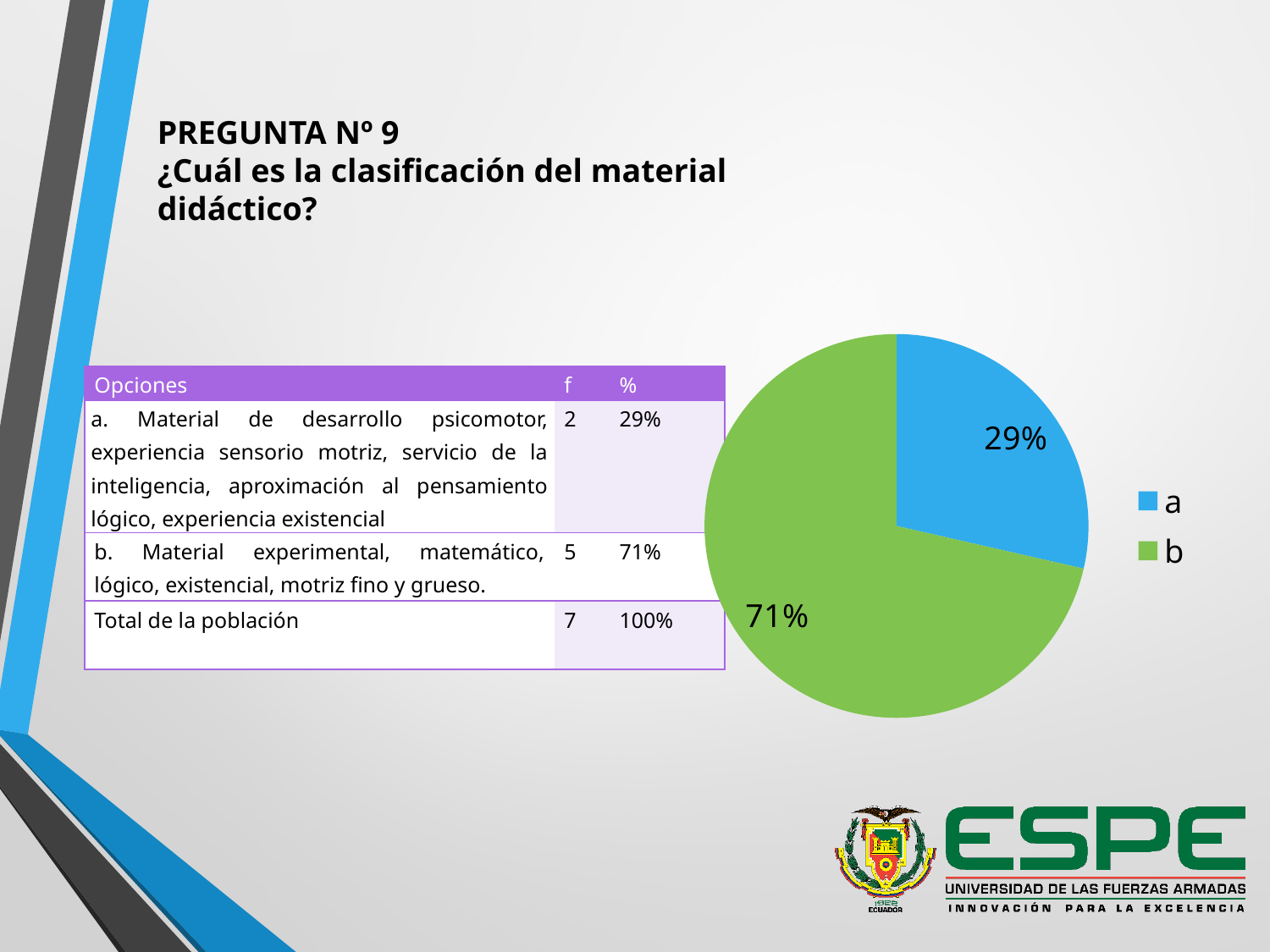
What kind of chart is shown on the slide? pie chart Which is larger in the pie chart, slice a or slice b? b What colour is slice a in the pie chart? blue What is the difference in percentage points between slice b and slice a? 42 Which slice of the pie chart is the largest? b What percentage does slice a represent in the pie chart? 29% What colour is slice b in the pie chart? green Is the share of slice b in the pie chart greater or less than 50%? greater What percentage does slice b represent in the pie chart? 71% How many entries does the legend of the pie chart list? 2 Which slice of the pie chart is the smallest? a How many slices does the pie chart have? 2